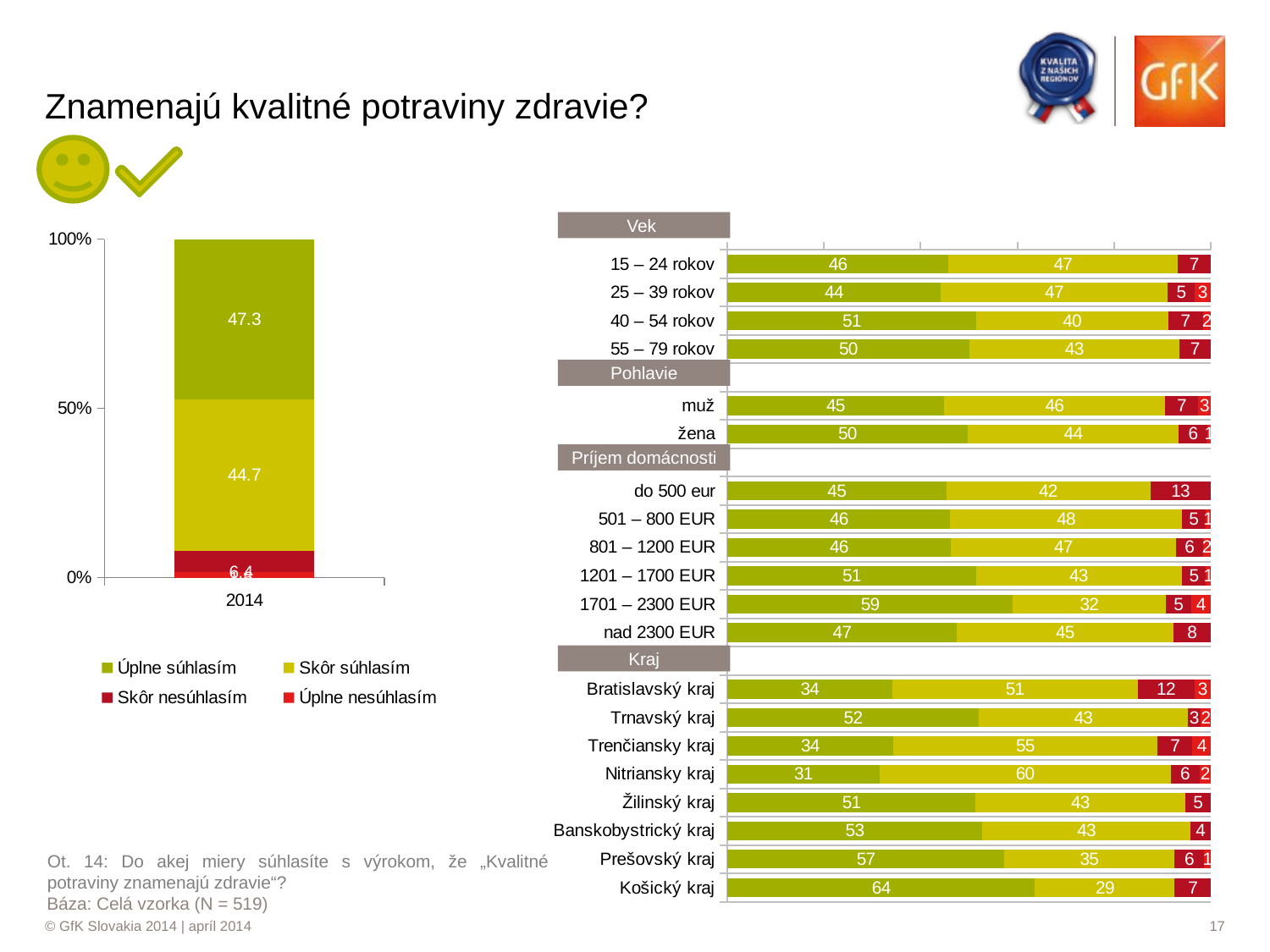
How many series does the legend of the left chart list? 4 In the right chart, what is the Úplne súhlasím (dark green) value for the income group 1701 – 2300 EUR? 59 In the right chart, which kraj has the highest Úplne súhlasím (dark green) value? Košický kraj In the right chart, which age group has the larger Úplne súhlasím value: 40 – 54 rokov or 25 – 39 rokov? 40 – 54 rokov What kind of chart is the left chart? stacked bar chart In the right chart, what is the Úplne súhlasím (dark green) value for Košický kraj? 64 In the right chart, what is the Skôr súhlasím (yellow) value for Nitriansky kraj? 60 In the left stacked bar chart, what is the value for Skôr súhlasím in 2014? 44.7 In the right chart, what is the Skôr nesúhlasím (dark red) value for the income group do 500 eur? 13 In the left stacked bar chart, what is the value for Úplne súhlasím in 2014? 47.3 In the right chart, what is the difference between the Úplne súhlasím values for Košický kraj and Nitriansky kraj? 33 In the right chart, which kraj has the lowest Úplne súhlasím (dark green) value? Nitriansky kraj